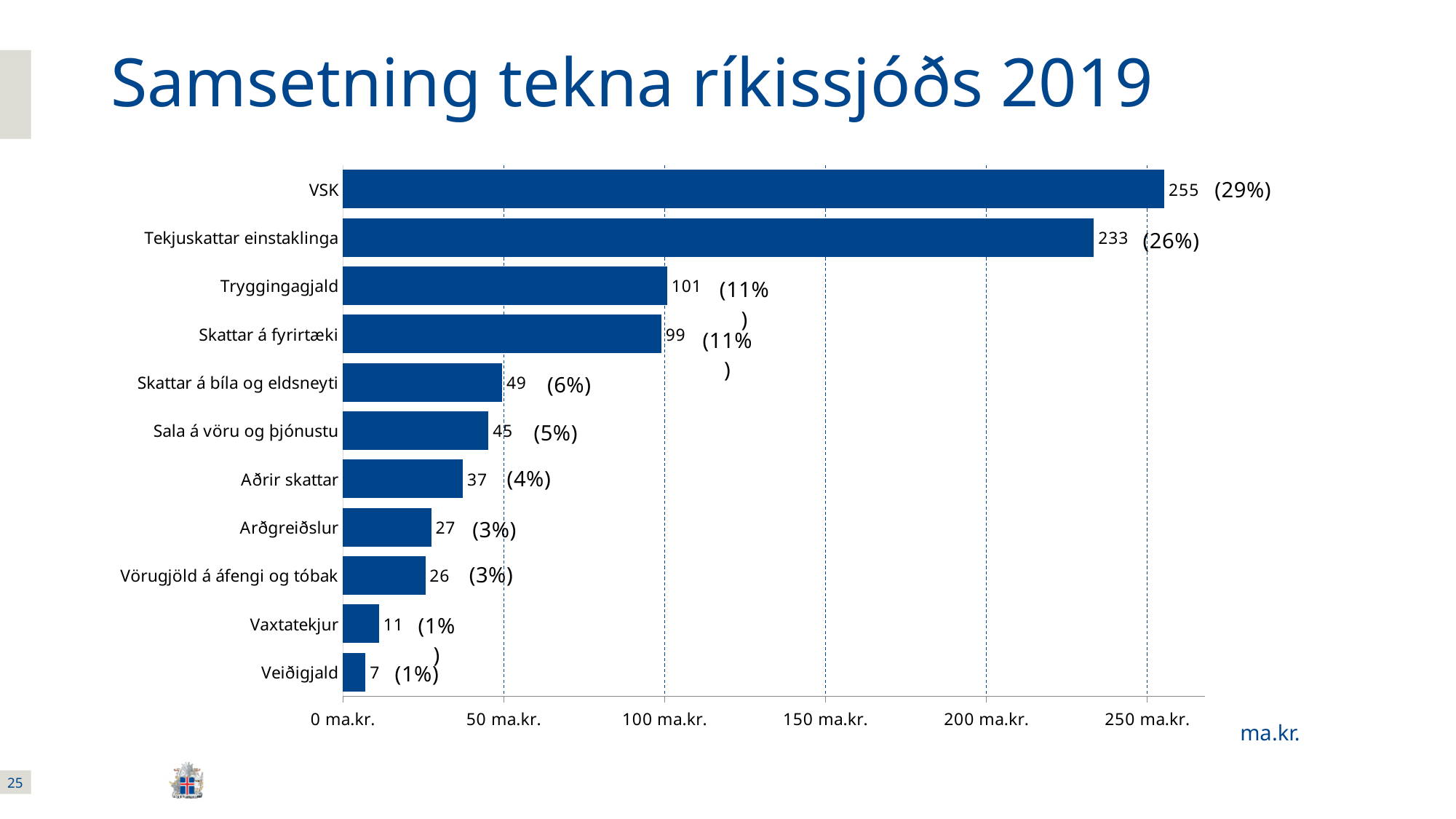
How many categories are shown in the chart? 11 What is the difference between the values for VSK and Tekjuskattar einstaklinga? 22 Which is larger, Skattar á bíla og eldsneyti or Sala á vöru og þjónustu? Skattar á bíla og eldsneyti Which category has the highest value? VSK Which category has the lowest value? Veiðigjald What is the value for Tryggingagjald? 101 Is the value for Tekjuskattar einstaklinga greater or less than 200 ma.kr.? greater What kind of chart is shown on the slide? bar chart What is the value for VSK? 255 What is the title of the slide? Samsetning tekna ríkissjóðs 2019 What is the value for Vörugjöld á áfengi og tóbak? 26 What percentage share is shown next to Tekjuskattar einstaklinga? 26%